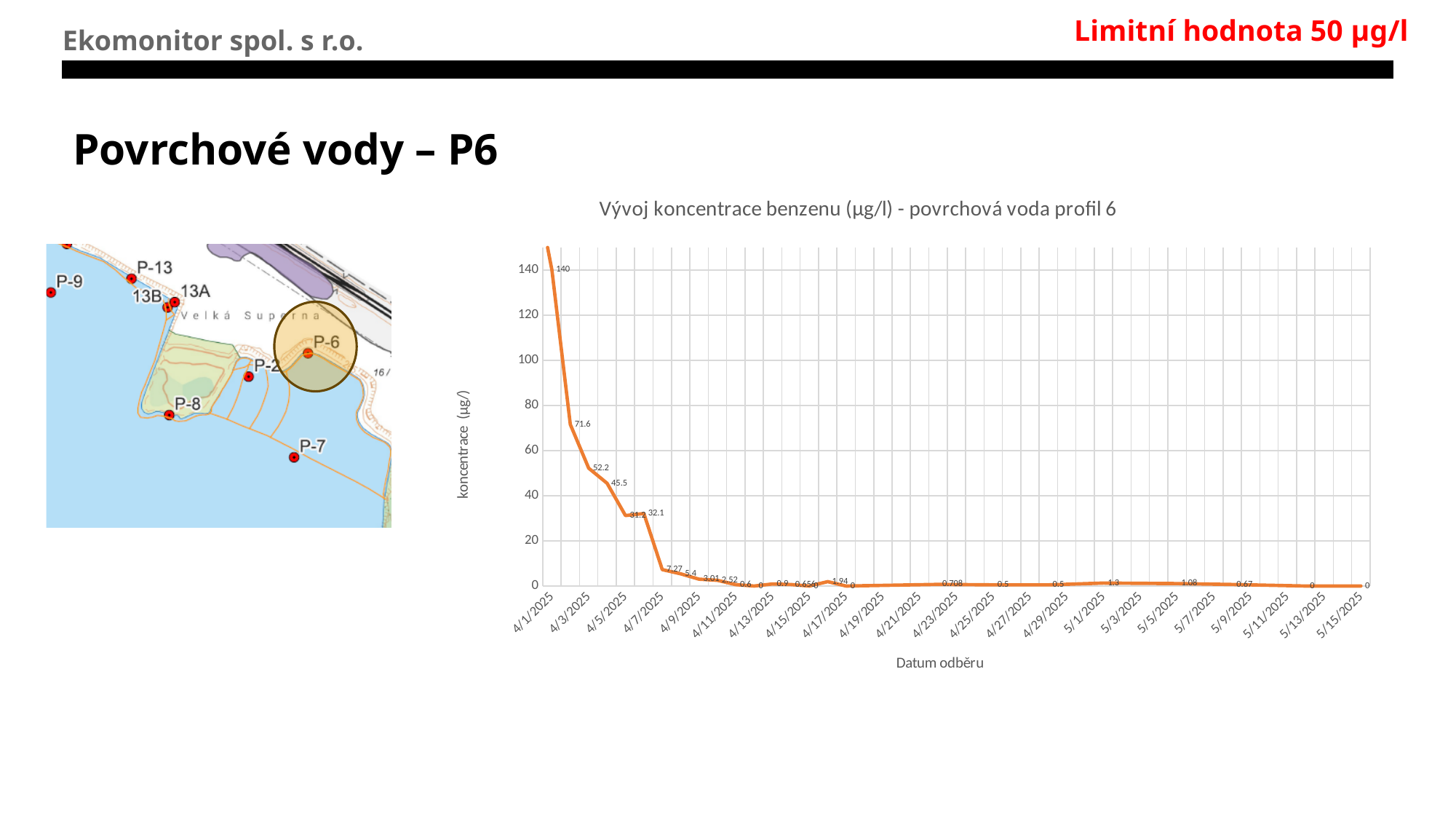
Is the value for 4/3/2025 greater or less than 40? greater Which is larger, the value at 4/1/2025 or the value at 4/5/2025? 4/1/2025 What is the lowest value plotted on the chart? 0 What is the highest value plotted on the chart? 140 Do the values generally rise or fall along the x axis from 4/1/2025 to 5/15/2025? fall What is the difference between the first data point (140) and the second data point (71.6)? 68.4 What type of chart is shown on the slide? line chart Is the value for 4/7/2025 greater or less than 20? less What is the title of the chart? Vývoj koncentrace benzenu (µg/l) - povrchová voda profil 6 What is the benzene concentration value at the first data point (4/1/2025)? 140 How many lines (data series) are plotted on the chart? 1 What is the label of the x axis of the chart? Datum odběru